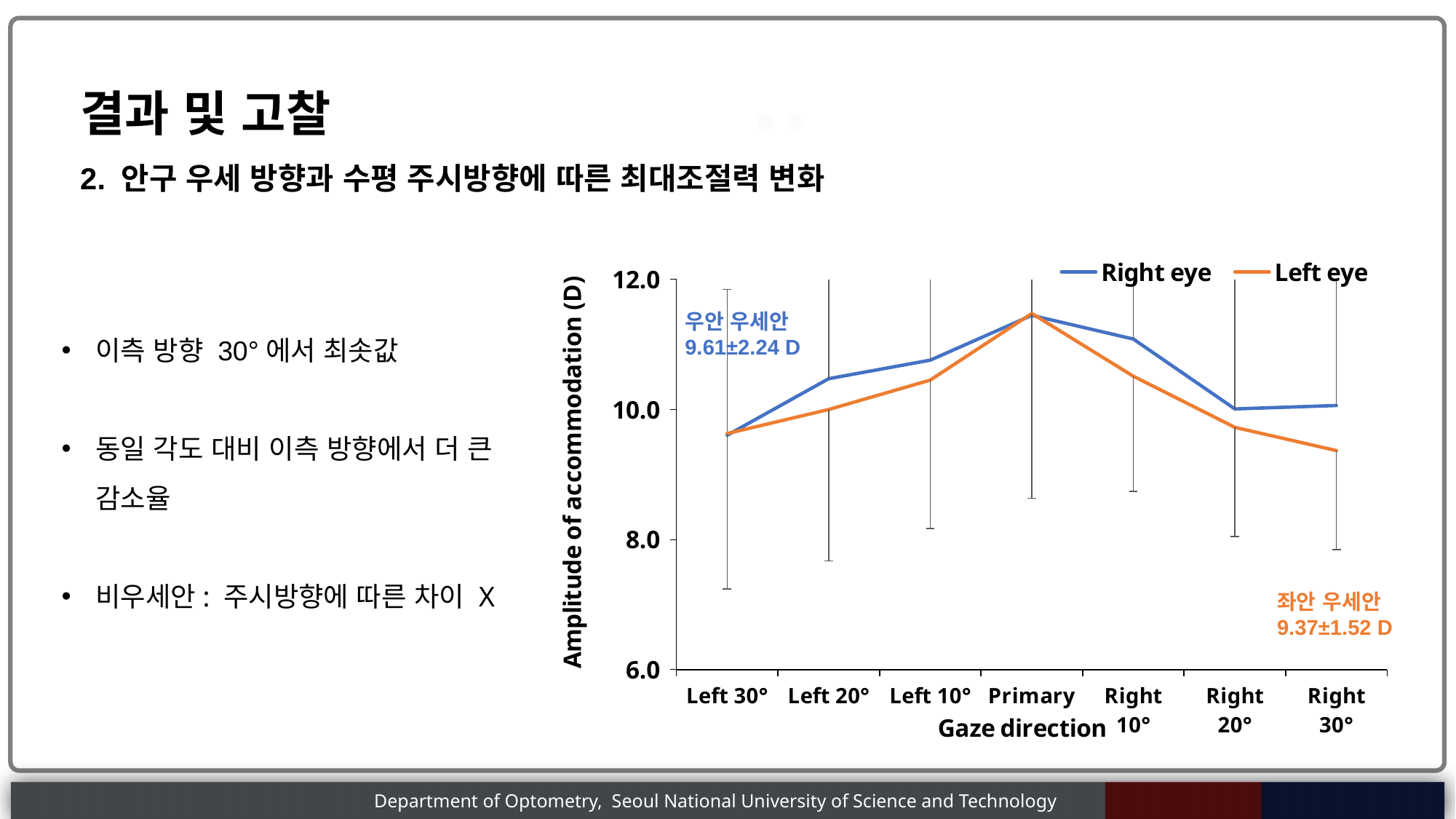
At which gaze direction does the Left eye series reach its lowest value? Right 30° What value is printed in the orange annotation labelled 좌안 우세안? 9.37±1.52 D How many series does the chart legend list? 2 At Right 30°, which series has the larger value, Right eye or Left eye? Right eye What are the two series named in the legend? Right eye, Left eye Does the Left eye series rise or fall from Primary to Right 30°? fall How many gaze direction categories are shown on the x axis? 7 Is the Right eye value at Primary greater or less than 10.0? greater Is the Left eye value at Right 30° greater or less than 10.0? less What kind of chart is shown on the slide? line chart At which gaze direction does the Right eye series reach its highest value? Primary What is the title of the y axis? Amplitude of accommodation (D)